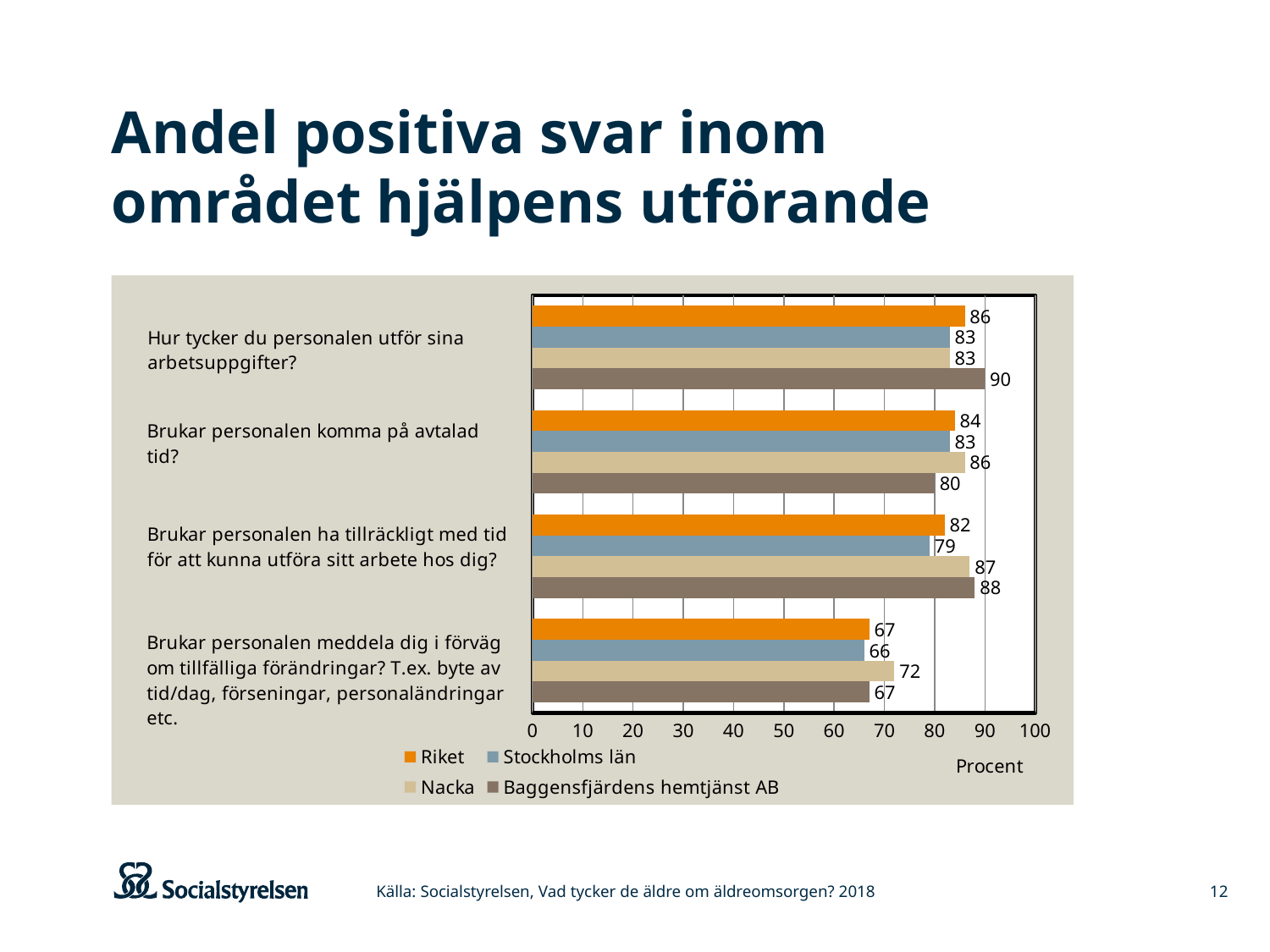
Which series has the lowest value on the question "Brukar personalen meddela dig i förväg om tillfälliga förändringar?"? Stockholms län What is the difference between Baggensfjärdens hemtjänst AB and Riket on the question "Brukar personalen ha tillräckligt med tid för att kunna utföra sitt arbete hos dig?"? 6 What is the value for Baggensfjärdens hemtjänst AB on the question "Brukar personalen komma på avtalad tid?"? 80 What is the value for Riket on the question "Hur tycker du personalen utför sina arbetsuppgifter?"? 86 On the question "Brukar personalen komma på avtalad tid?", which is larger: Nacka or Riket? Nacka Which series has the highest value on the question "Hur tycker du personalen utför sina arbetsuppgifter?"? Baggensfjärdens hemtjänst AB How many questions (categories) are shown in the chart? 4 What is the value for Nacka on the question "Brukar personalen meddela dig i förväg om tillfälliga förändringar?"? 72 What is the label of the horizontal axis? Procent What kind of chart is shown on the slide? Bar chart How many series does the legend list? 4 What is the value for Stockholms län on the question "Brukar personalen ha tillräckligt med tid för att kunna utföra sitt arbete hos dig?"? 79